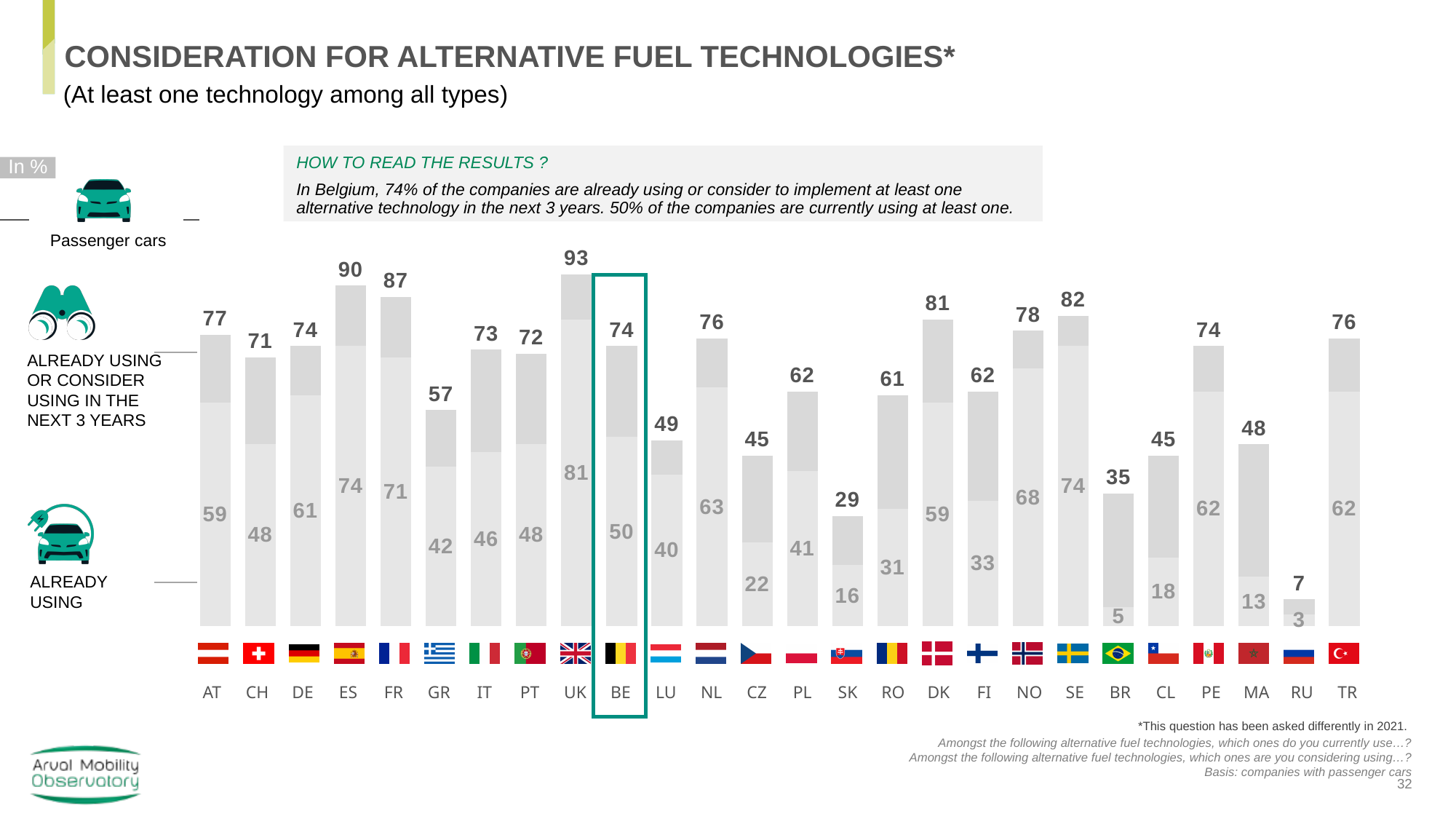
What kind of chart is shown on the slide? Bar chart What is the value for 'already using or consider using in the next 3 years' for Belgium (BE)? 74 What is the difference between the 'already using or consider using' values for Spain (ES) and France (FR)? 3 Which country's bar is highlighted with a green outline on the chart? BE What is the 'already using' value for the UK? 81 What is the difference between the 'already using or consider using' value and the 'already using' value for Brazil (BR)? 30 How many series does the chart show? 2 Which is larger: the 'already using' value for Sweden (SE) or for Norway (NO)? Sweden (SE) Which country has the highest 'already using or consider using in the next 3 years' value? UK How many countries are shown on the x axis of the chart? 26 Which country has the lowest 'already using' value? RU What is the 'already using' value for Slovakia (SK)? 16